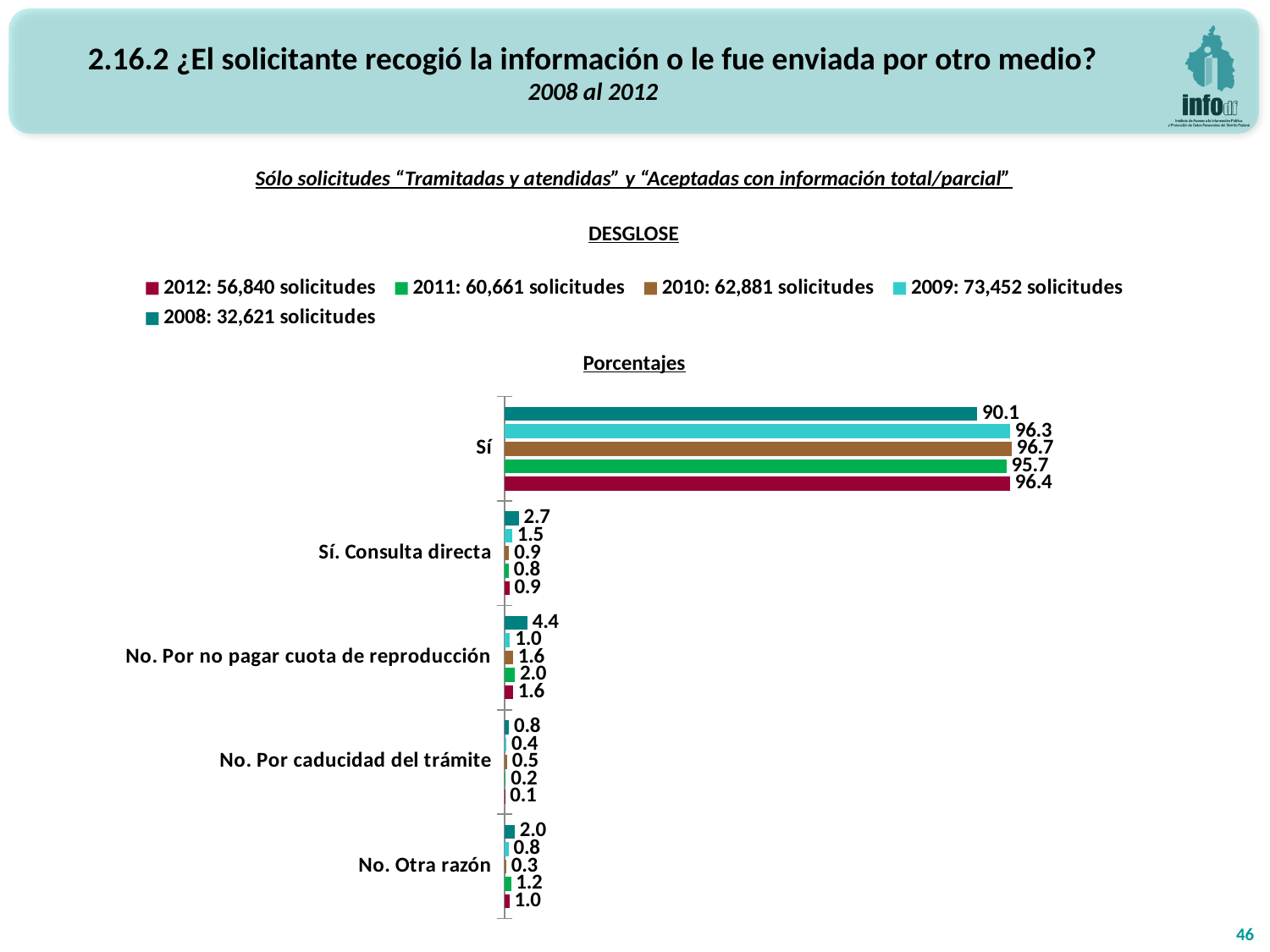
What is the value for 'No. Por no pagar cuota de reproducción' in the 2008 series? 4.4 According to the legend, how many solicitudes were there in 2009? 73,452 Which is larger for 'No. Por caducidad del trámite': the 2008 value or the 2012 value? 2008 What kind of chart is shown on the slide? bar chart Which year has the lowest value for 'Sí'? 2008 What is the value for 'Sí' in the 2010 series? 96.7 How many categories are shown on the chart? 5 What is the value for 'Sí' in the 2008 series? 90.1 What is the value for 'No. Otra razón' in the 2011 series? 1.2 What is the difference between the 2010 and 2008 values for 'Sí'? 6.6 Which year has the highest value for 'Sí. Consulta directa'? 2008 How many series does the legend list? 5